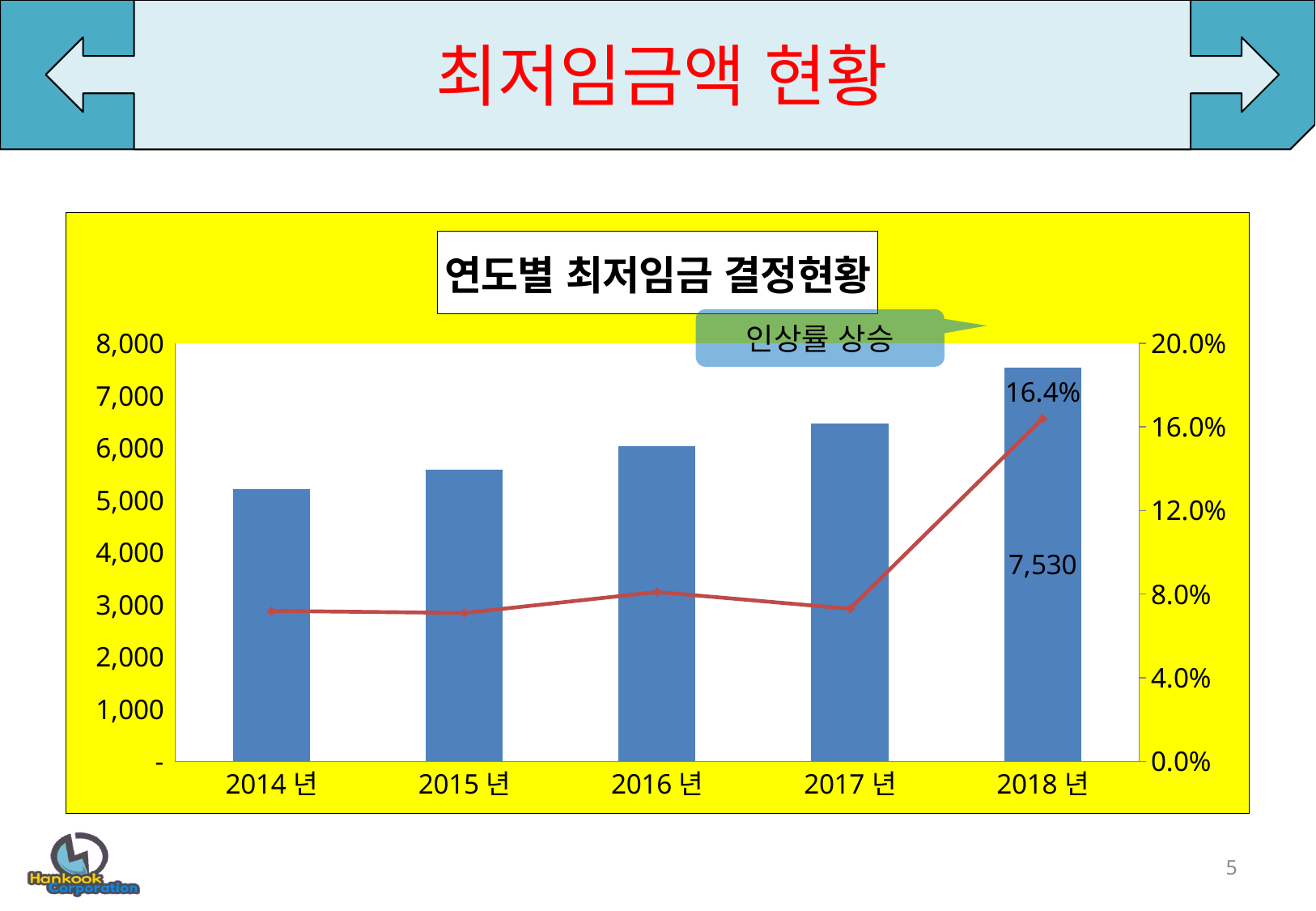
Which bar is taller, 2015 년 or 2017 년? 2017 년 Which year has the tallest bar? 2018 년 Is the line value for 2014 년 greater or less than 8.0%? less Is the bar value for 2017 년 greater or less than 6,000? greater What is the title of the chart? 연도별 최저임금 결정현황 What kind of chart is used to show the minimum wage amounts by year? bar chart Do the bar values rise or fall from 2014 년 to 2018 년? rise How many years are shown on the x axis of the chart? 5 What text is shown in the callout above the chart area? 인상률 상승 What is the minimum wage value labelled on the bar for 2018 년? 7,530 What is the increase rate labelled on the line for 2018 년? 16.4% Which year has the shortest bar? 2014 년